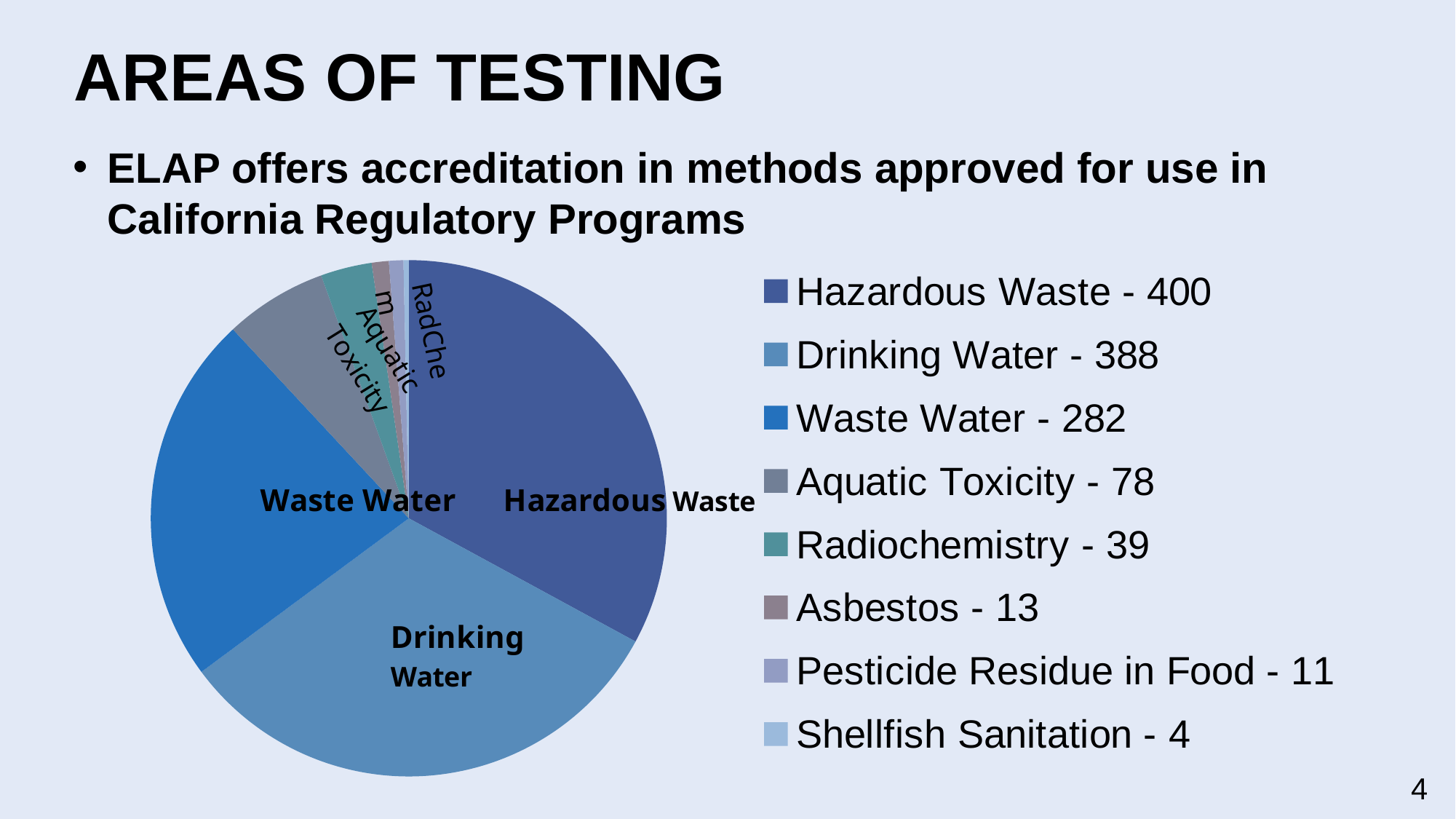
What is the value for Pesticide Residue in Food in the pie chart? 11 What is the value for Aquatic Toxicity in the pie chart? 78 How many categories does the pie chart show? 8 Which is larger, Drinking Water or Waste Water? Drinking Water What is the difference between the values for Waste Water and Aquatic Toxicity? 204 What is the value for Hazardous Waste in the pie chart? 400 What colour is the Waste Water slice in the pie chart? Blue What kind of chart is shown on the slide? Pie chart What is the total of all the values shown in the pie chart's legend? 1215 Which category has the smallest slice in the pie chart? Shellfish Sanitation What is the difference between the values for Hazardous Waste and Drinking Water? 12 Which category has the largest slice in the pie chart? Hazardous Waste